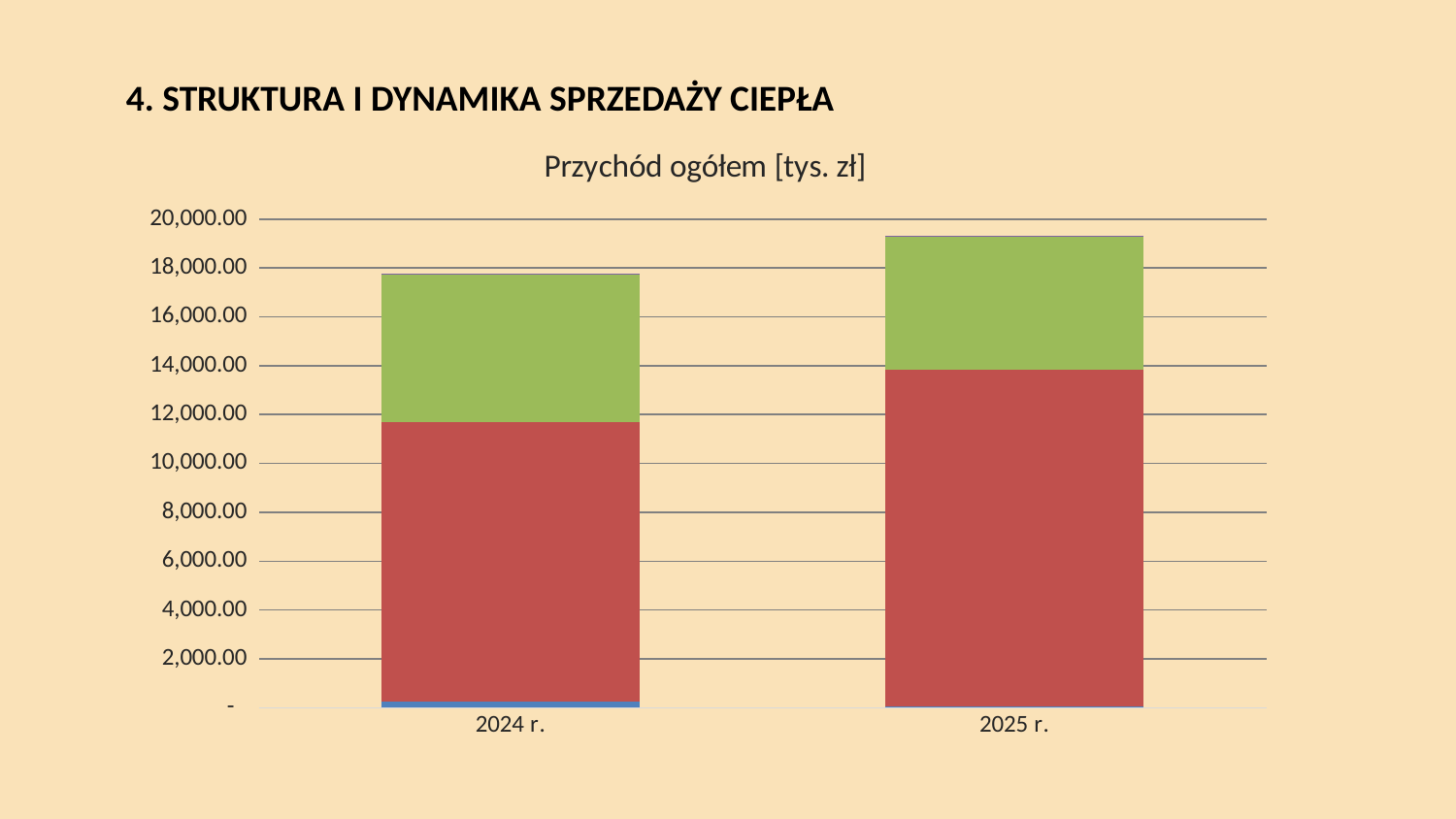
Does the total revenue rise or fall from 2024 r. to 2025 r.? rise Which year has the lower total bar in the chart? 2024 r. Is the total bar for 2025 r. larger or smaller than the total bar for 2024 r.? larger What kind of chart is shown on the slide? stacked bar chart Is the red segment for 2024 r. greater or less than 10,000.00? greater What is the title of the chart? Przychód ogółem [tys. zł] How many categories are shown on the x axis of the chart? 2 Is the total value for 2025 r. greater or less than 20,000.00? less Is the total value for 2025 r. greater or less than 18,000.00? greater Is the red segment for 2025 r. larger or smaller than the red segment for 2024 r.? larger Which year has the higher total bar in the chart? 2025 r.